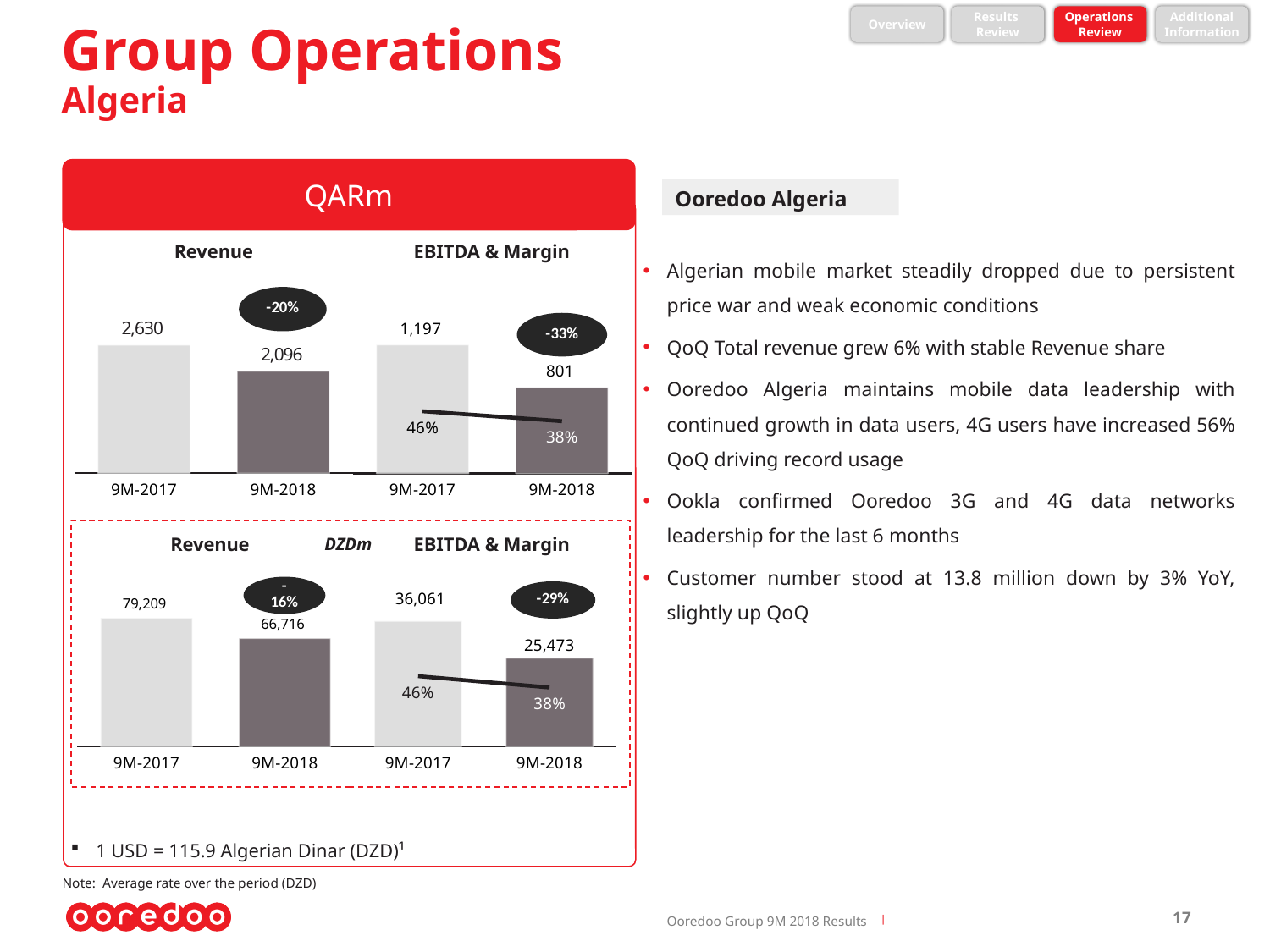
In the QARm Revenue chart, what is the revenue for 9M-2017? 2,630 What type of chart is the QARm Revenue chart? bar chart In the QARm EBITDA & Margin chart, which period has the higher EBITDA, 9M-2017 or 9M-2018? 9M-2017 In the QARm Revenue chart, what is the revenue for 9M-2018? 2,096 In the DZDm Revenue chart, what is the revenue for 9M-2017? 79,209 In the DZDm Revenue chart, does revenue rise or fall from 9M-2017 to 9M-2018? fall In the QARm EBITDA & Margin chart, what is the EBITDA margin for 9M-2017? 46% In the DZDm EBITDA & Margin chart, what is the difference in EBITDA between 9M-2017 and 9M-2018? 10,588 What percentage change is shown in the oval on the DZDm EBITDA & Margin chart? -29% In the DZDm EBITDA & Margin chart, what is the EBITDA for 9M-2018? 25,473 In the QARm Revenue chart, what is the difference in revenue between 9M-2017 and 9M-2018? 534 In the QARm EBITDA & Margin chart, what is the EBITDA for 9M-2018? 801